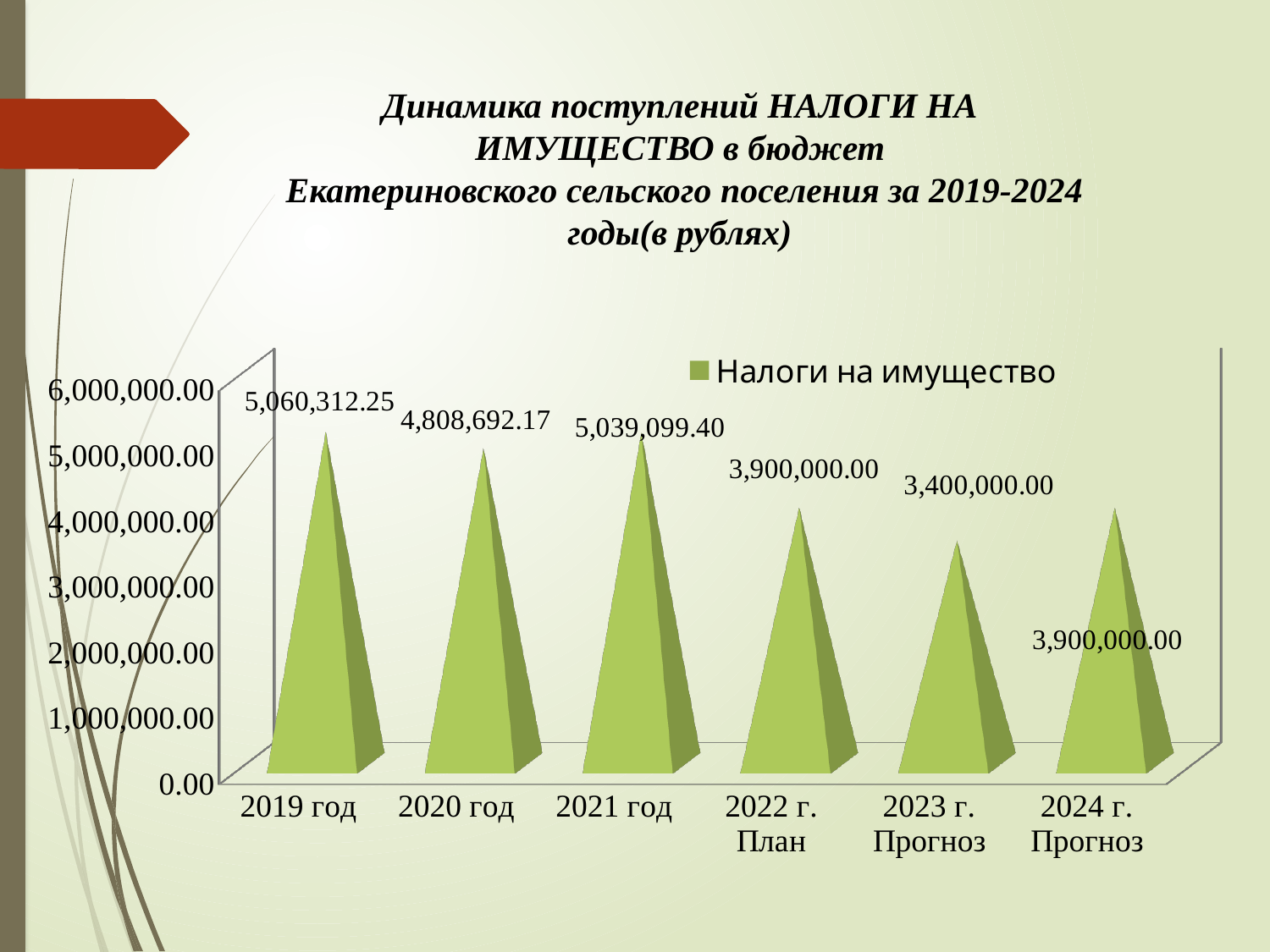
What is the value for 2021 год? 5,039,099.40 What series name is listed in the legend? Налоги на имущество How many categories are shown on the x axis? 6 What kind of chart is shown on the slide? Bar chart What is the difference between the values for 2022 г. План and 2023 г. Прогноз? 500,000.00 What is the value for 2020 год? 4,808,692.17 Which is larger, the value for 2021 год or the value for 2022 г. План? 2021 год What is the difference between the values for 2019 год and 2020 год? 251,620.08 What is the value for 2023 г. Прогноз? 3,400,000.00 Which category has the lowest value? 2023 г. Прогноз Which category has the highest value? 2019 год What is the value for 2019 год? 5,060,312.25